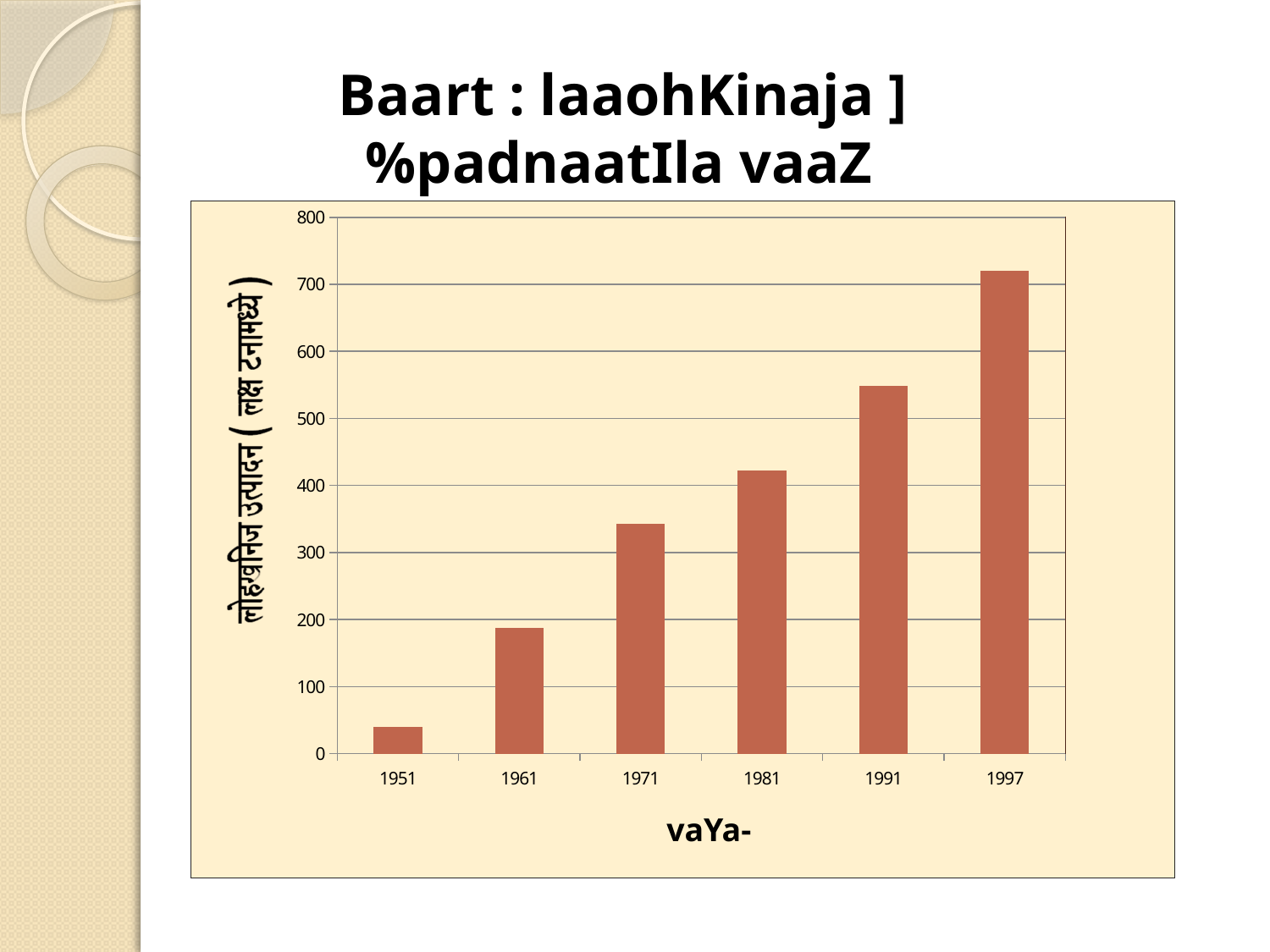
Which year has the highest bar in the chart? 1997 Is the value for 1961 greater or less than 200? less Do the values rise or fall from 1951 to 1997? rise Is the value for 1951 greater or less than 100? less Is the value for 1997 greater or less than 700? greater How many years are shown on the x axis of the chart? 6 Which is larger, the value for 1971 or the value for 1981? 1981 What kind of chart is shown on the slide? bar chart What is the x-axis title of the chart? vaYa- Which year has the lowest bar in the chart? 1951